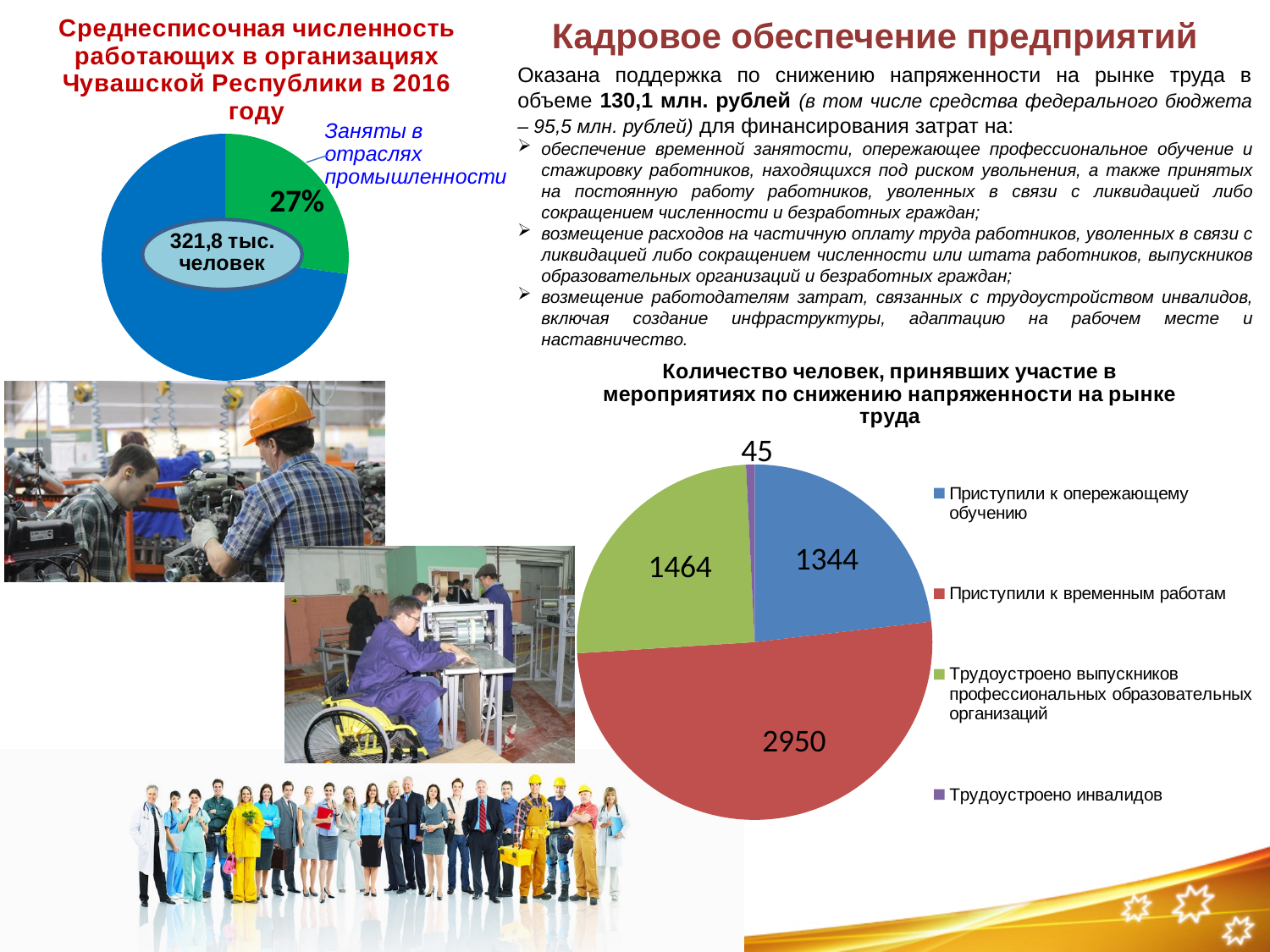
On the chart 'Количество человек, принявших участие в мероприятиях по снижению напряженности на рынке труда', what is the value for 'Приступили к опережающему обучению'? 1344 On the chart 'Количество человек, принявших участие в мероприятиях по снижению напряженности на рынке труда', what is the value for 'Приступили к временным работам'? 2950 What kind of chart is 'Количество человек, принявших участие в мероприятиях по снижению напряженности на рынке труда'? Pie chart On the pie chart 'Среднесписочная численность работающих в организациях Чувашской Республики в 2016 году', what total figure is printed in the centre of the pie? 321,8 тыс. человек On the chart 'Количество человек, принявших участие в мероприятиях по снижению напряженности на рынке труда', what is the value for 'Трудоустроено инвалидов'? 45 On the chart 'Количество человек, принявших участие в мероприятиях по снижению напряженности на рынке труда', which category has the largest value? Приступили к временным работам On the chart 'Количество человек, принявших участие в мероприятиях по снижению напряженности на рынке труда', which is larger: 'Трудоустроено выпускников профессиональных образовательных организаций' or 'Приступили к опережающему обучению'? Трудоустроено выпускников профессиональных образовательных организаций On the chart 'Количество человек, принявших участие в мероприятиях по снижению напряженности на рынке труда', how many categories does the legend list? 4 On the pie chart 'Среднесписочная численность работающих в организациях Чувашской Республики в 2016 году', what percentage is shown for 'Заняты в отраслях промышленности'? 27% On the chart 'Количество человек, принявших участие в мероприятиях по снижению напряженности на рынке труда', which category has the smallest value? Трудоустроено инвалидов On the chart 'Количество человек, принявших участие в мероприятиях по снижению напряженности на рынке труда', what is the total of all four slices? 5803 On the chart 'Количество человек, принявших участие в мероприятиях по снижению напряженности на рынке труда', what is the difference between 'Трудоустроено выпускников профессиональных образовательных организаций' and 'Приступили к опережающему обучению'? 120